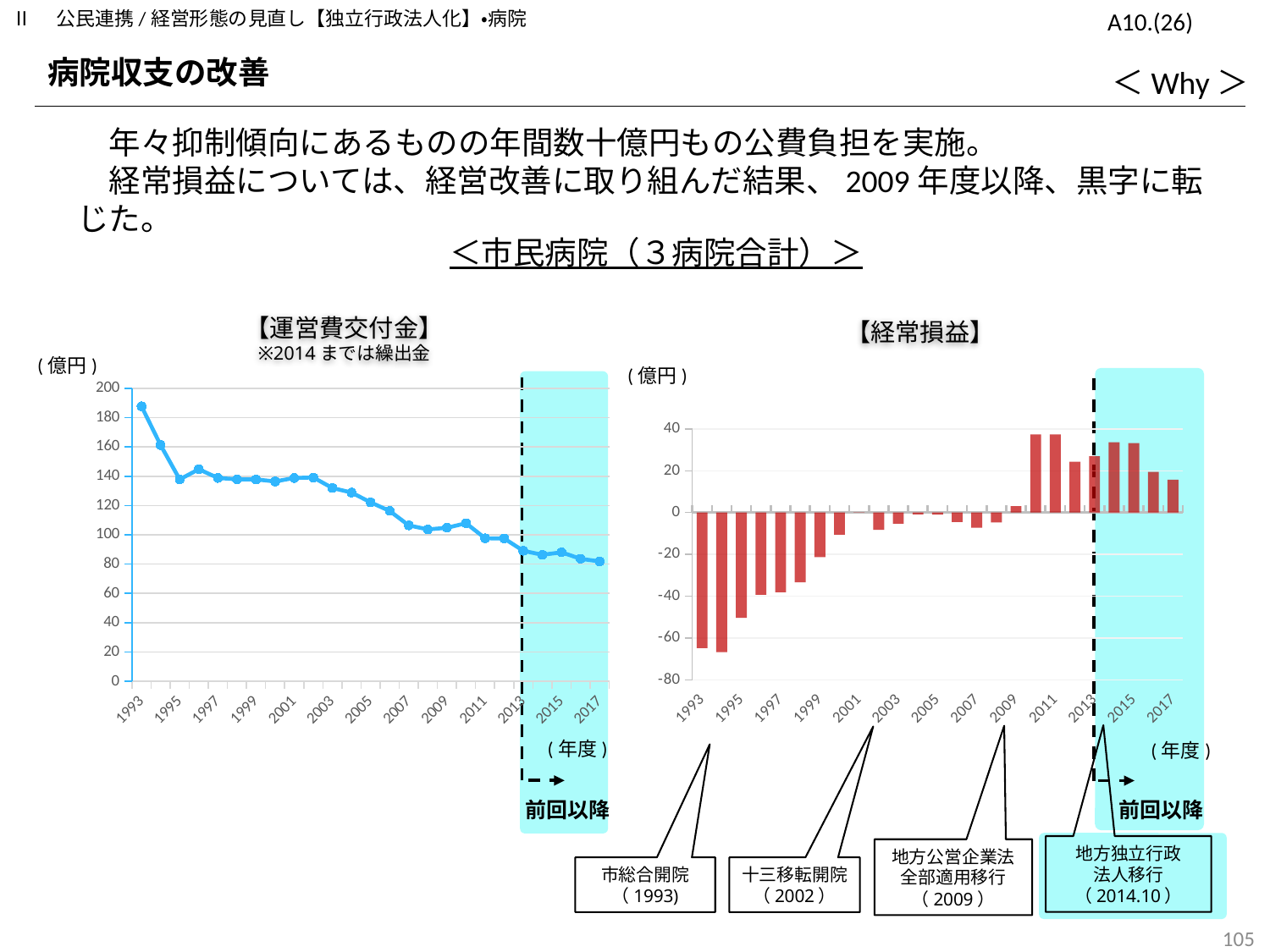
What kind of chart is the 【運営費交付金】 chart on the left? line chart In the 【運営費交付金】 chart, is the value for 2017 greater or less than 100? less In the 【経常損益】 chart, do the values generally rise or fall from 1993 to 2017? rise In the 【運営費交付金】 chart, which year has the lowest value? 2017 In the 【経常損益】 chart, which is larger, the value for 2010 or the value for 2017? 2010 In the 【運営費交付金】 chart, is the value for 1993 greater or less than 180? greater What kind of chart is the 【経常損益】 chart on the right? bar chart In the 【経常損益】 chart, is the value for 1993 greater or less than -60? less In the 【運営費交付金】 chart, which year has the highest value? 1993 In the 【運営費交付金】 chart, do the values generally rise or fall from 1993 to 2017? fall What unit is shown on the y axis of the 【運営費交付金】 chart? 億円